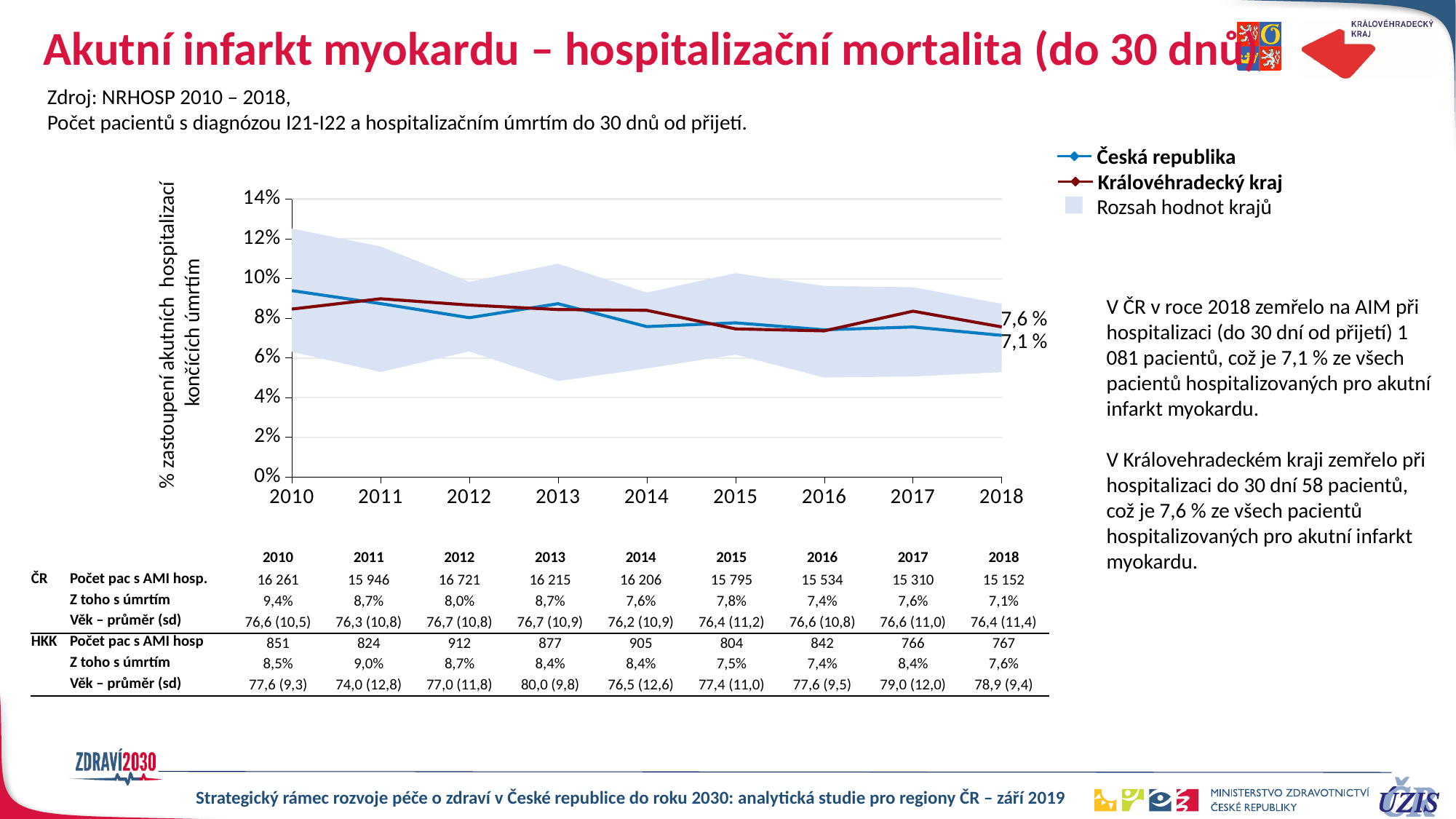
What type of chart is shown on the slide? line chart What is the value for Česká republika in 2018? 7,1 % Which series is drawn in dark red? Královéhradecký kraj What is the difference between the Královéhradecký kraj and Česká republika values in 2018? 0,5 % How many years are shown on the x axis of the chart? 9 What is the value for Královéhradecký kraj in 2018? 7,6 % Is the value for Česká republika in 2010 greater or less than 8%? greater How many entries does the chart legend list? 3 In which year is the Česká republika value lowest? 2018 In 2010, which is higher: Česká republika or Královéhradecký kraj? Česká republika In which year is the Česká republika value highest? 2010 Does the Česká republika line rise or fall overall from 2010 to 2018? fall